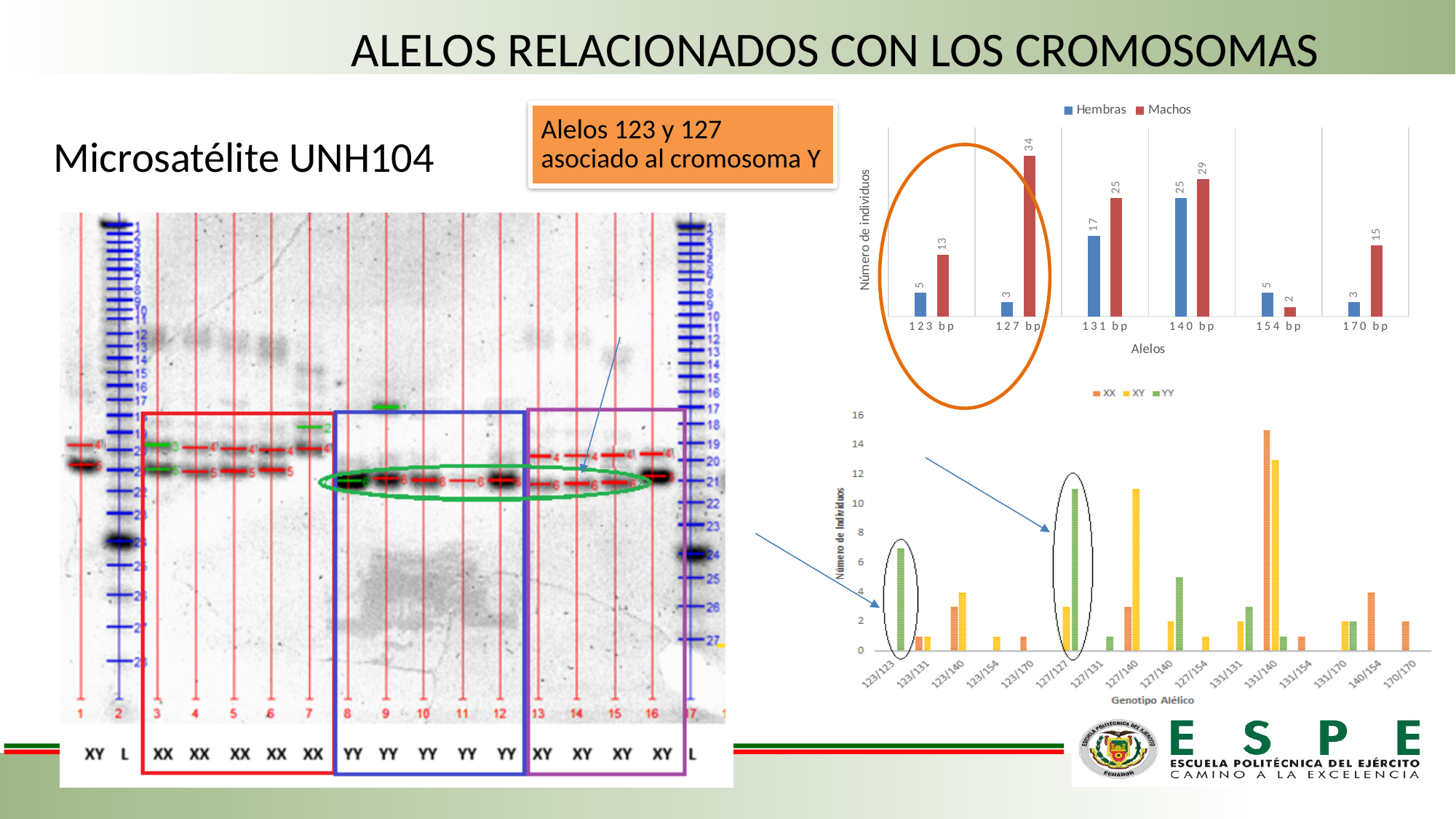
In the top-right chart (Hembras/Machos by allele), what is the value for Machos at 127 bp? 34 In the bottom-right chart (XX/XY/YY by genotype), how many series does the legend list? 3 In the top-right chart (Hembras/Machos by allele), how many alleles are shown on the x axis? 6 In the top-right chart (Hembras/Machos by allele), which is larger at 154 bp, Hembras or Machos? Hembras In the top-right chart (Hembras/Machos by allele), how many series does the legend list? 2 In the top-right chart (Hembras/Machos by allele), which allele has the lowest Machos value? 154 bp In the top-right chart (Hembras/Machos by allele), what is the value for Hembras at 140 bp? 25 In the bottom-right chart (XX/XY/YY by genotype), is the XX value for 131/140 greater or less than 14? greater In the top-right chart (Hembras/Machos by allele), what is the difference between Machos and Hembras at 131 bp? 8 In the top-right chart (Hembras/Machos by allele), which allele has the highest Machos value? 127 bp In the top-right chart (Hembras/Machos by allele), what is the value for Machos at 154 bp? 2 What kind of chart is the bottom-right chart (XX/XY/YY by genotype)? bar chart